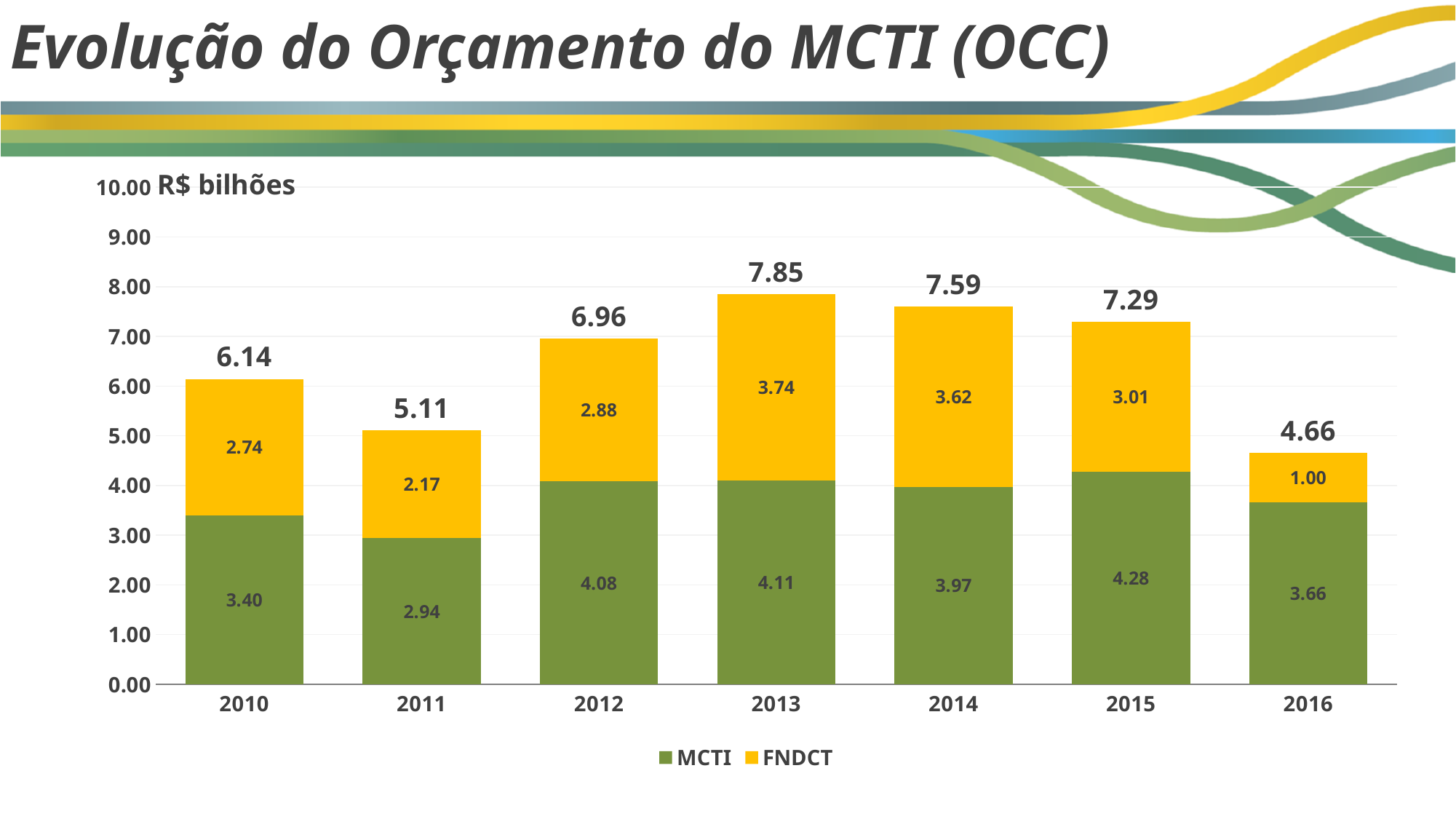
Is the total for 2011 greater or less than 6.00? less How many series does the legend list? 2 What kind of chart is shown on the slide? stacked bar chart What is the MCTI value for 2013? 4.11 Which year has the lowest FNDCT value? 2016 How many years are shown on the x axis? 7 What is the difference between the FNDCT values for 2013 and 2016? 2.74 Which year has the highest total budget? 2013 What unit is shown at the top of the y axis? R$ bilhões What is the total of the stacked bar for 2014? 7.59 Which is larger, the MCTI value for 2015 or the MCTI value for 2012? 2015 What is the FNDCT value for 2011? 2.17